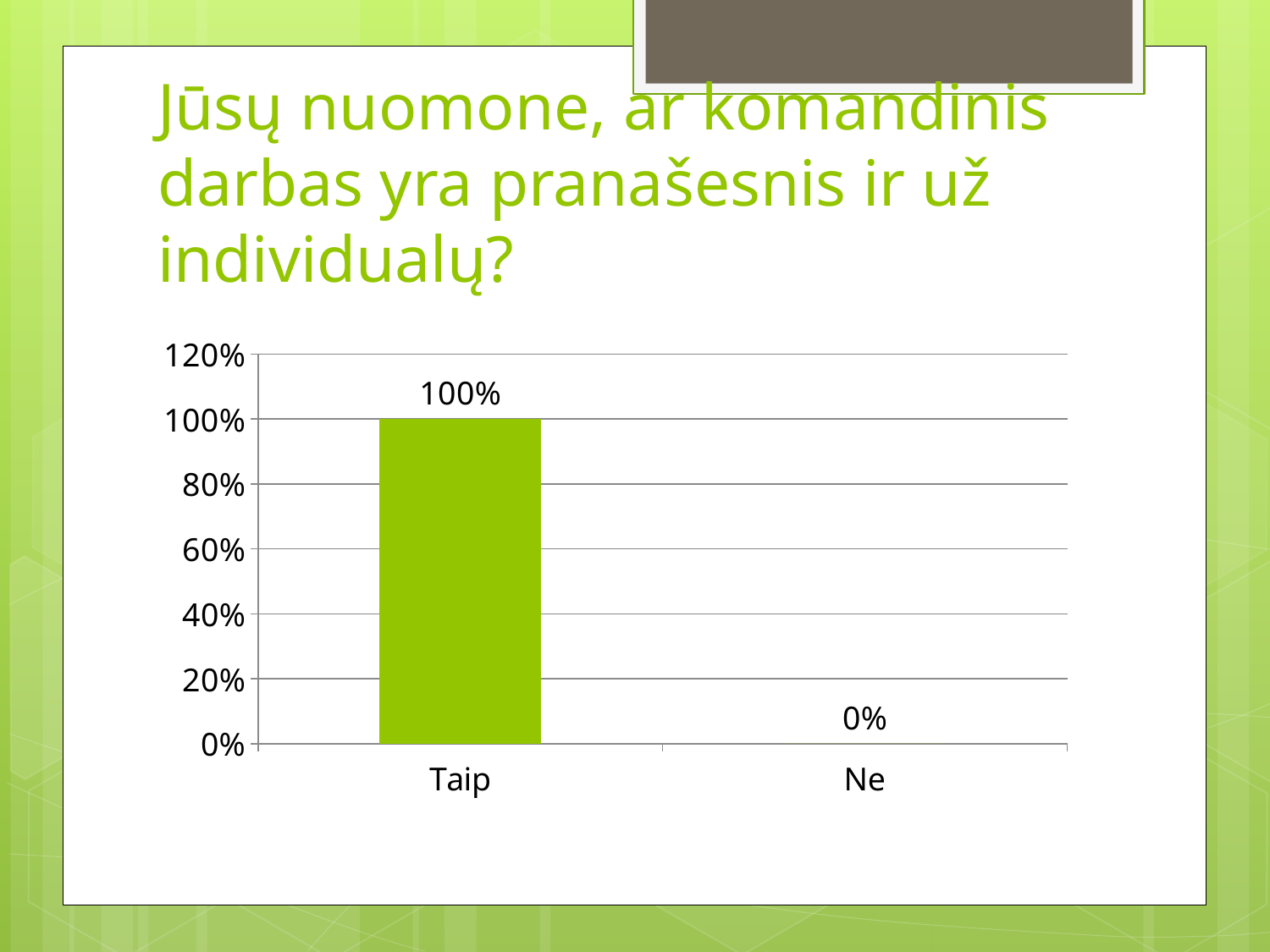
What is the value for Taip? 100% Is the value for Taip greater or less than 80%? greater Which category has the lowest value? Ne What colour is the bar for Taip? green How many categories are shown on the x axis? 2 What kind of chart is shown on the slide? bar chart What is the value for Ne? 0% Do the values rise or fall from Taip to Ne? fall What is the highest tick value shown on the y axis? 120% Which category has the highest value? Taip Which is larger, the value for Taip or the value for Ne? Taip What is the difference between the values for Taip and Ne? 100%